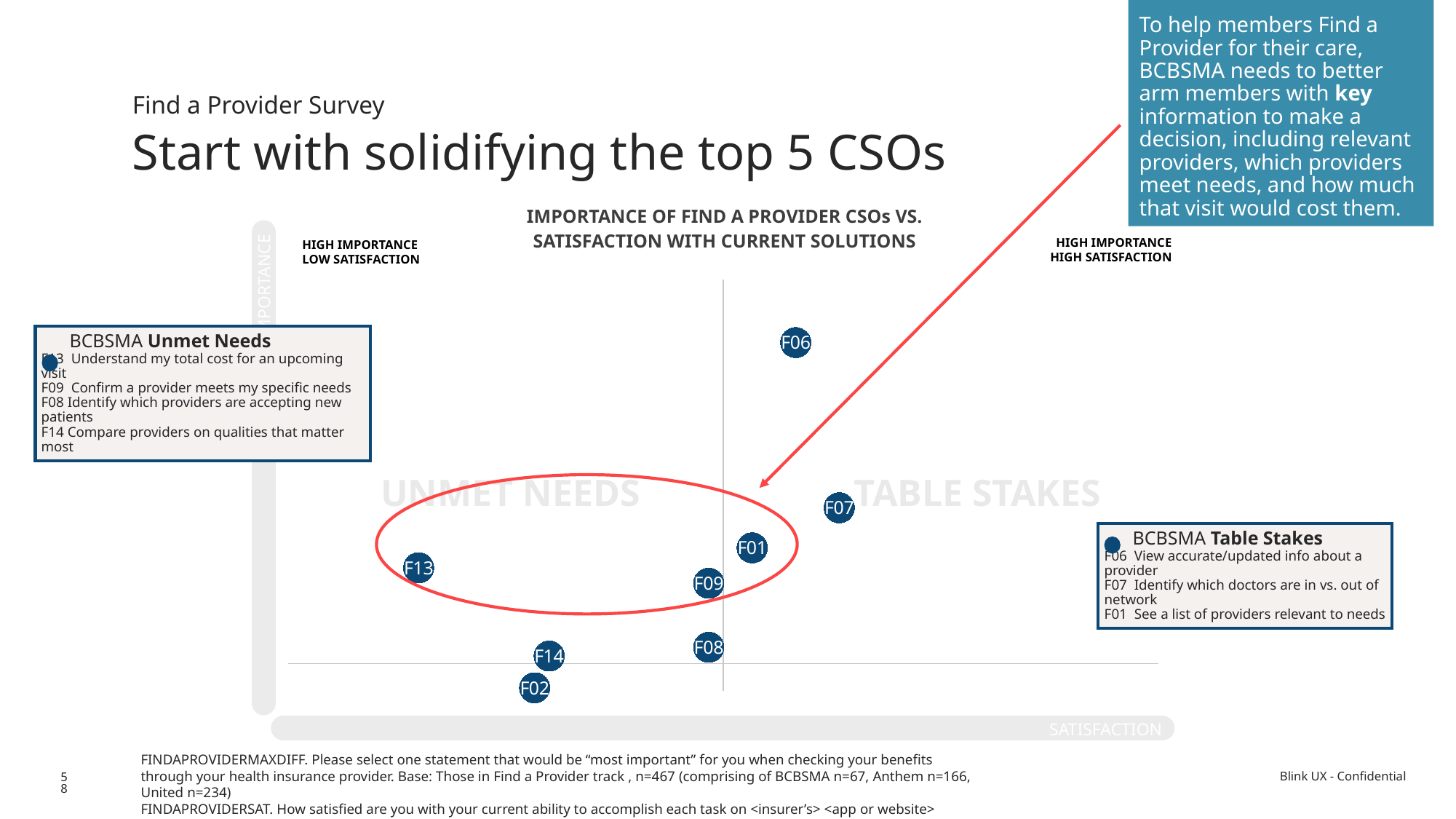
Which point is plotted higher on the importance axis, F13 or F14? F13 How many data points are plotted on the chart? 8 Which point is plotted further right on the satisfaction axis, F01 or F09? F01 Which point has the highest satisfaction (is plotted furthest to the right)? F07 What label is shown on the horizontal axis of the chart? SATISFACTION Which point has the lowest satisfaction (is plotted furthest to the left)? F13 Which point is plotted further right on the satisfaction axis, F07 or F13? F07 Which point has the lowest importance (is plotted lowest on the chart)? F02 Which point has the highest importance (is plotted highest on the chart)? F06 What kind of chart is shown on the slide? Scatter plot What is the title of the chart? IMPORTANCE OF FIND A PROVIDER CSOs VS. SATISFACTION WITH CURRENT SOLUTIONS